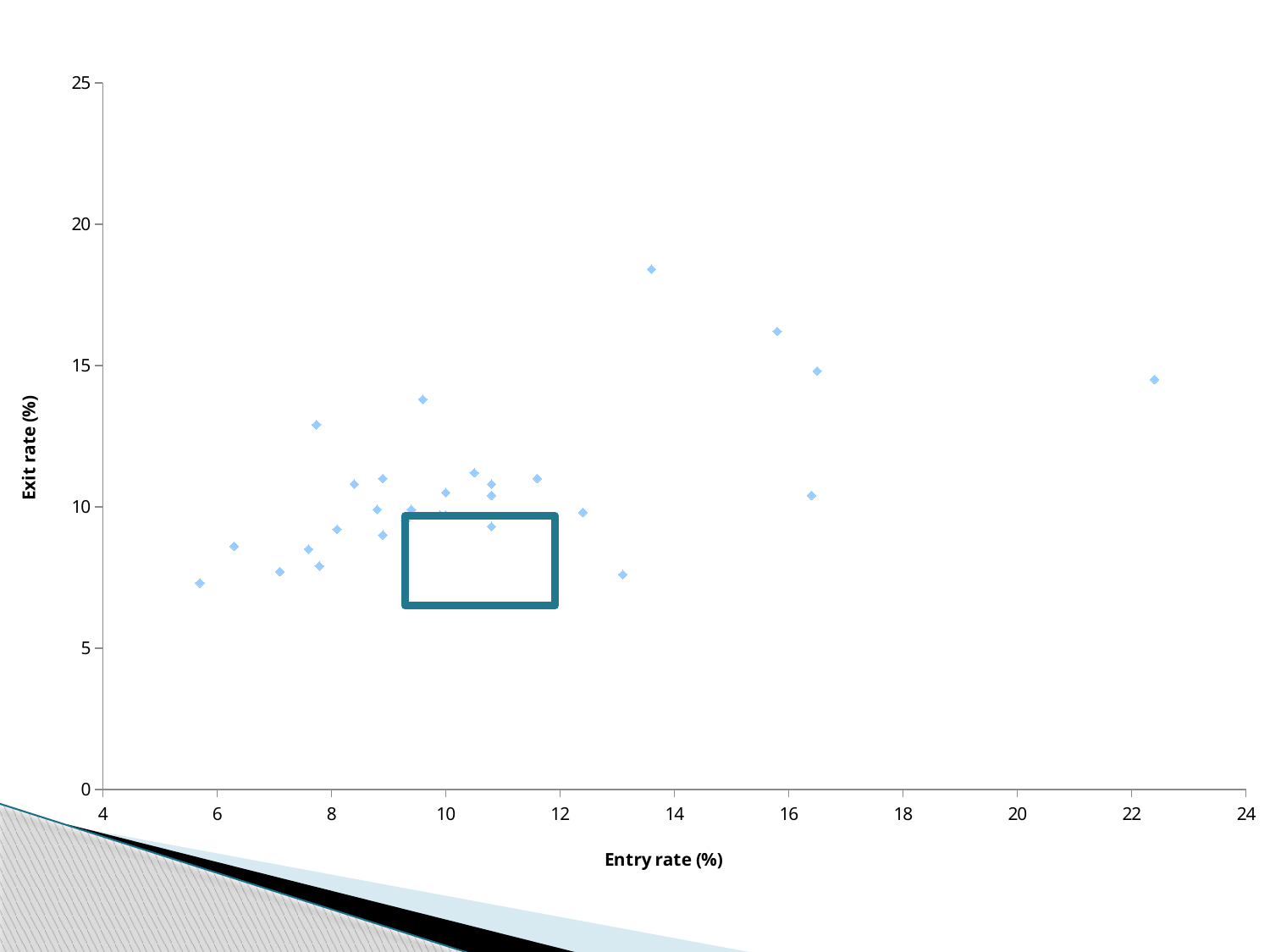
Is the entry rate of the leftmost point greater or less than 6? less What kind of chart is shown on the slide? scatter chart Is the entry rate of the point with the highest exit rate greater or less than 12? greater Is the exit rate of the point with the highest entry rate greater or less than 10? greater Which has the higher exit rate: the point with the highest entry rate or the point with the highest exit rate? the point with the highest exit rate What is the label of the vertical axis? Exit rate (%) Do points with higher entry rates tend to have higher or lower exit rates? higher What is the label of the horizontal axis? Entry rate (%)